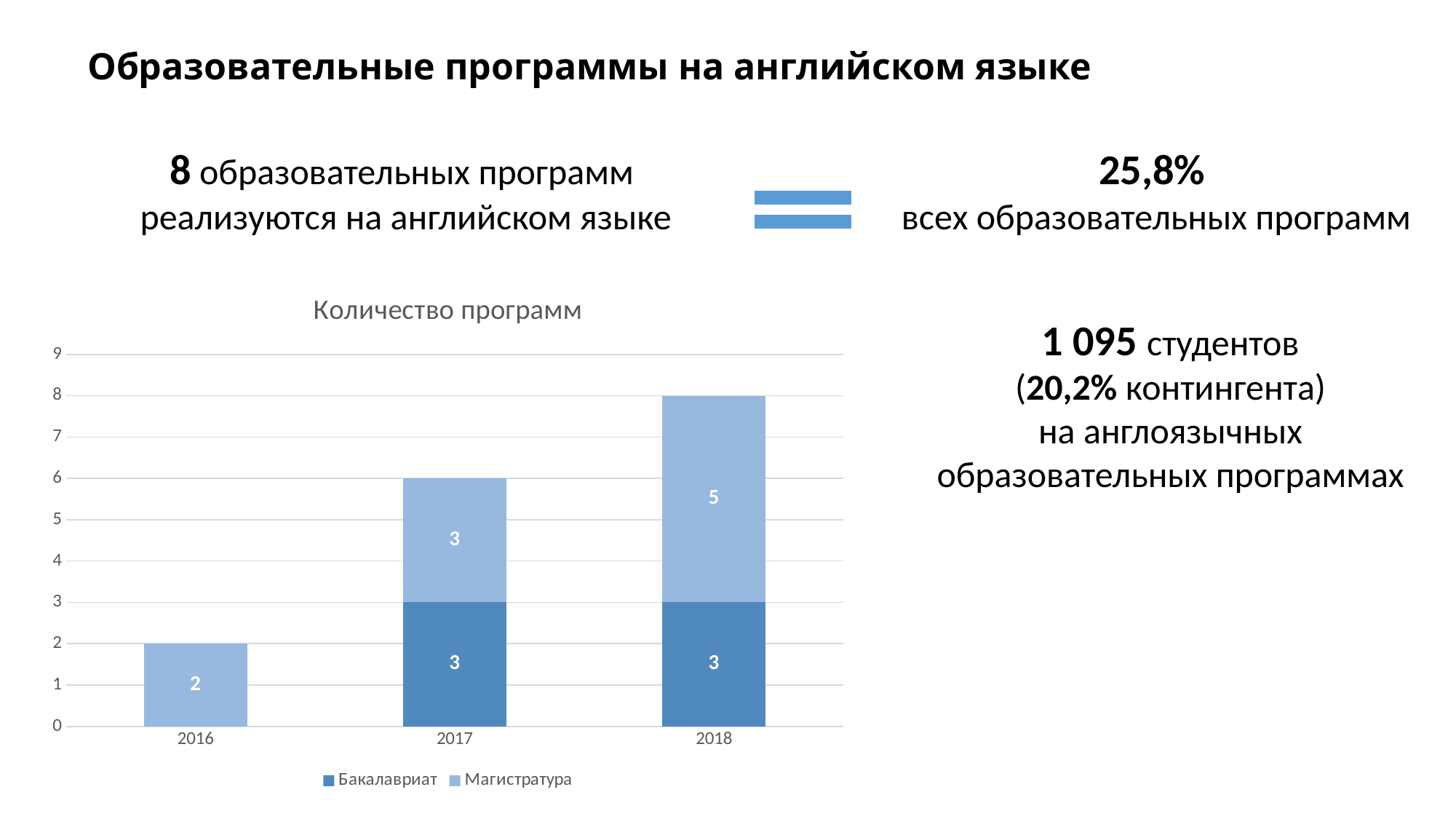
What is the value for Магистратура in 2018? 5 Which year has the highest total number of programs? 2018 How many years are shown on the x axis of the "Количество программ" chart? 3 Do the total values rise or fall from 2016 to 2018? rise Which year has the lowest total number of programs? 2016 What is the total height of the stacked bar for 2017? 6 What is the value for Магистратура in 2016? 2 What type of chart is shown under the title "Количество программ"? stacked bar chart What is the total height of the stacked bar for 2018? 8 How many series does the legend of the "Количество программ" chart list? 2 What is the value for Бакалавриат in 2017? 3 What is the difference between the Магистратура values for 2018 and 2017? 2